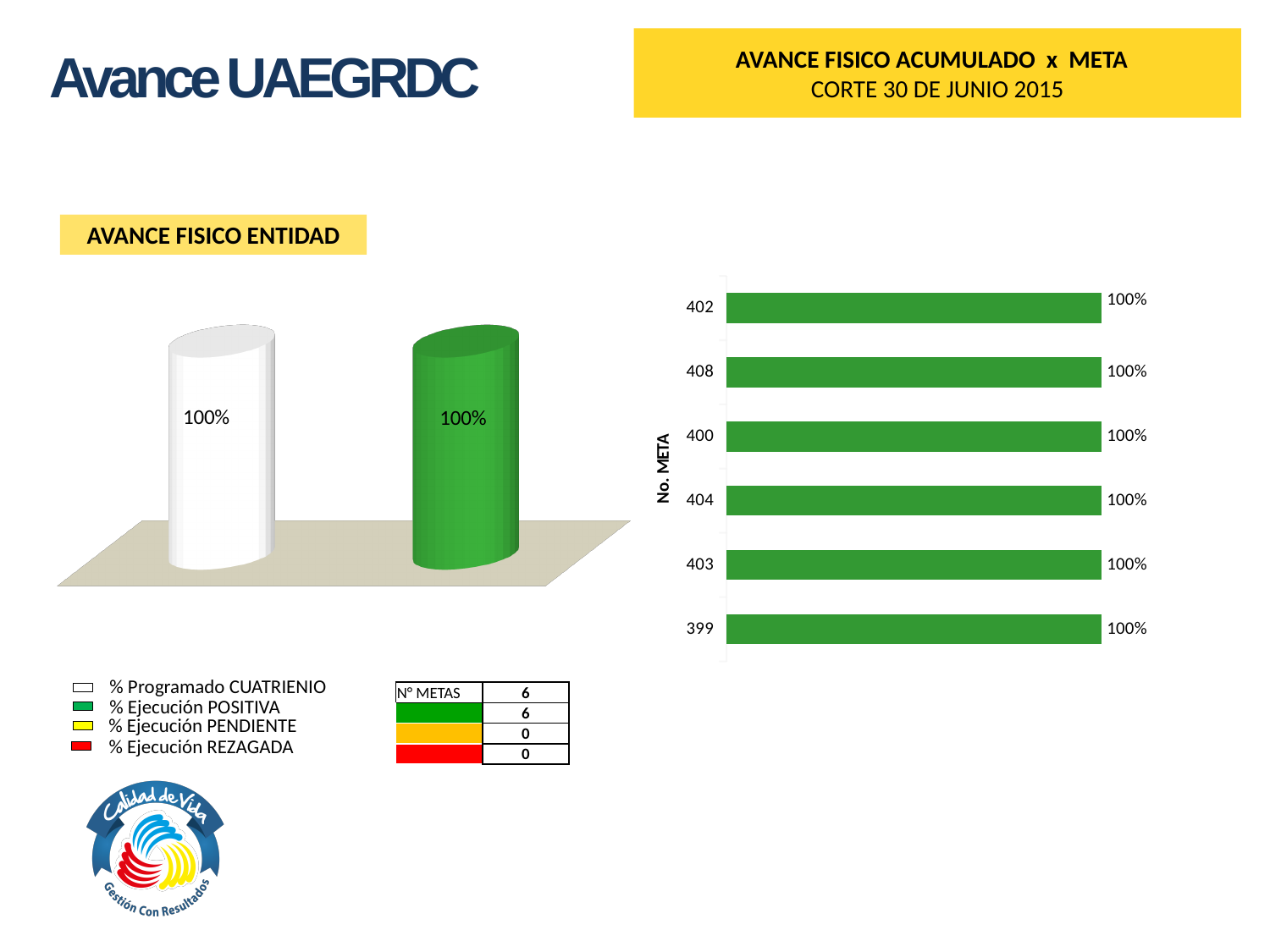
In the AVANCE FISICO ACUMULADO x META chart, what is the value for meta 404? 100% How many entries does the legend below the AVANCE FISICO ENTIDAD chart list? 4 In the AVANCE FISICO ENTIDAD chart, what is the value of the white cylinder (% Programado CUATRIENIO)? 100% How many metas are plotted in the AVANCE FISICO ACUMULADO x META chart? 6 In the AVANCE FISICO ENTIDAD chart, what is the value of the green cylinder (% Ejecución POSITIVA)? 100% In the AVANCE FISICO ACUMULADO x META chart, what is the value for meta 402? 100% In the AVANCE FISICO ACUMULADO x META chart, what is the difference between the values for meta 408 and meta 403? 0% How many cylinders are plotted in the AVANCE FISICO ENTIDAD chart? 2 In the AVANCE FISICO ACUMULADO x META chart, what is the value for meta 399? 100% What is the label of the vertical axis in the AVANCE FISICO ACUMULADO x META chart? No. META In the AVANCE FISICO ACUMULADO x META chart, is the value for meta 400 greater or less than 50%? greater What kind of chart is the AVANCE FISICO ACUMULADO x META chart? Bar chart